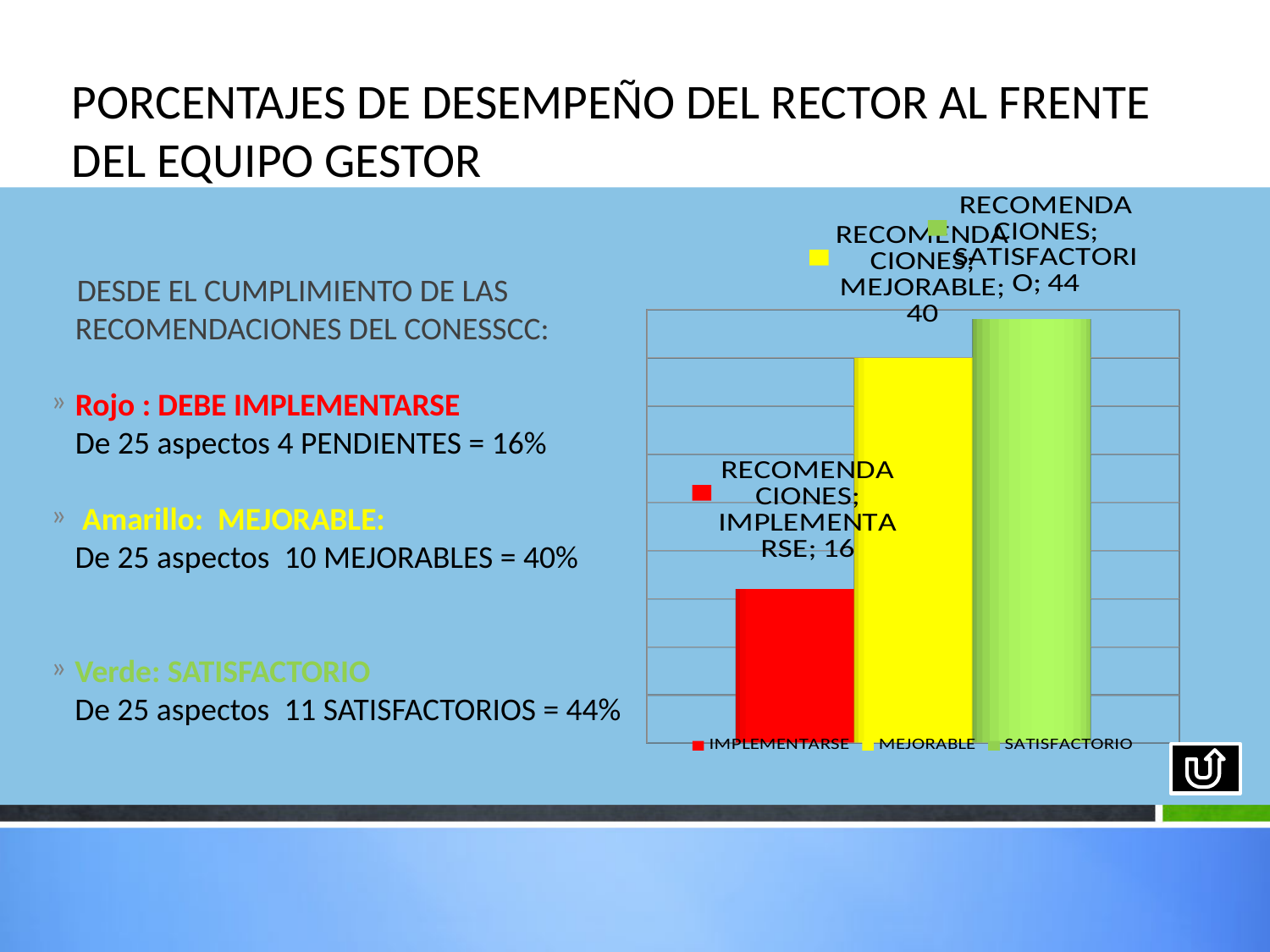
How many bars are plotted in the chart? 3 What colour is the bar for MEJORABLE? yellow How many entries does the chart legend list? 3 Which is larger, the value for MEJORABLE or the value for IMPLEMENTARSE? MEJORABLE What kind of chart is shown on the slide? bar chart What is the value for IMPLEMENTARSE in the chart? 16 Which category has the lowest value in the chart? IMPLEMENTARSE Which category has the highest value in the chart? SATISFACTORIO What is the value for MEJORABLE in the chart? 40 What is the difference between the values for SATISFACTORIO and IMPLEMENTARSE? 28 What is the difference between the values for MEJORABLE and IMPLEMENTARSE? 24 What is the value for SATISFACTORIO in the chart? 44